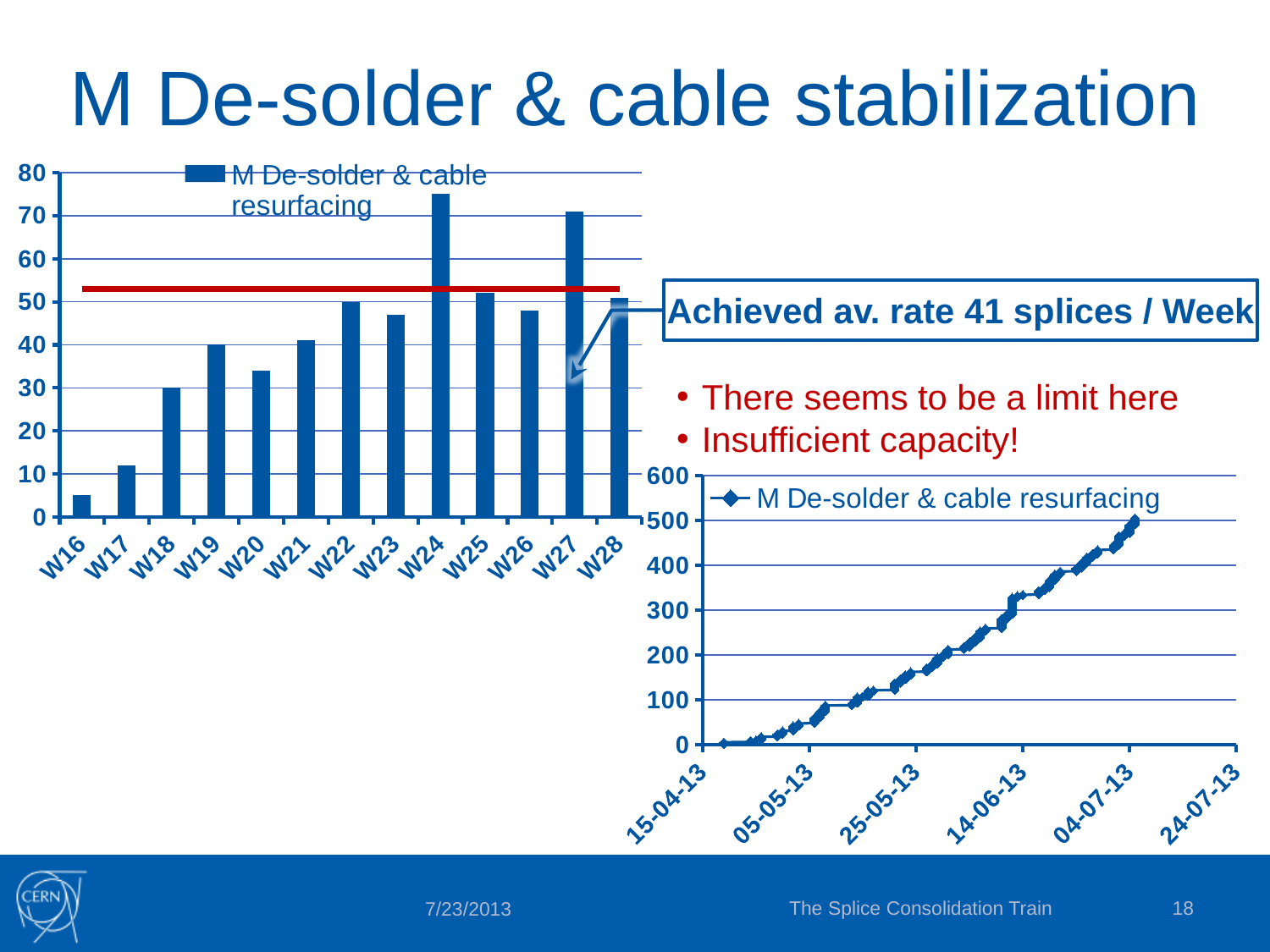
In the bar chart on the left, is the value for W18 greater or less than 40? less In the bar chart on the left, is the value for W24 greater or less than 70? greater In the line chart on the lower right, how many series does the legend list? 1 In the bar chart on the left, is the value for W17 greater or less than 20? less What kind of chart is the chart on the left of the slide? bar chart In the bar chart on the left, how many weeks are shown on the x axis? 13 What kind of chart is the chart on the lower right of the slide? line chart In the line chart on the lower right, do the values rise or fall along the x axis? rise In the bar chart on the left, which week has the highest value? W24 In the bar chart on the left, which is larger, the value for W24 or the value for W27? W24 In the bar chart on the left, which week has the lowest value? W16